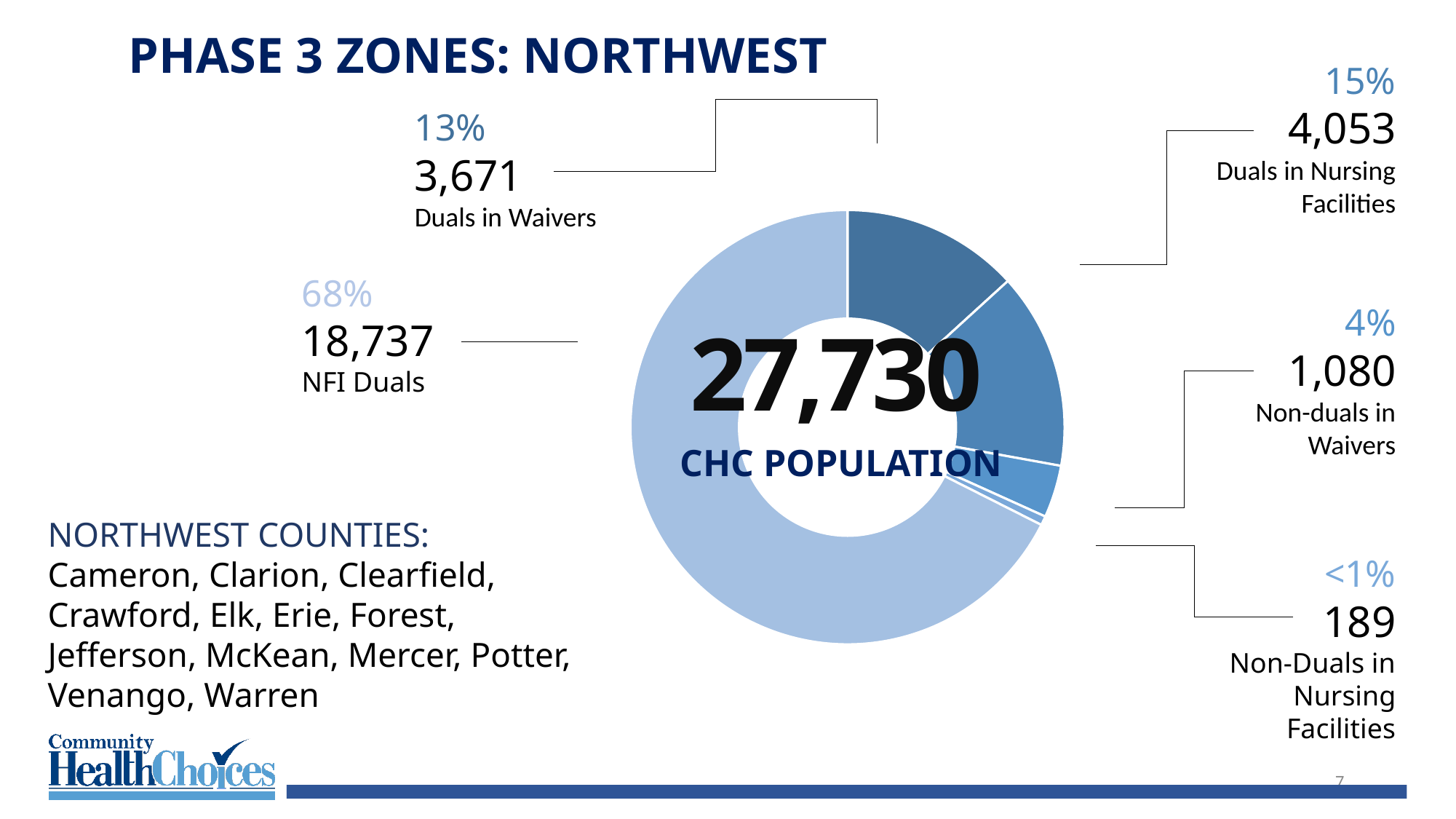
How many categories does the chart show? 5 What percentage of the CHC population are Duals in Nursing Facilities? 15% How many Duals in Waivers are shown? 3,671 Which category has the smallest share of the CHC population? Non-Duals in Nursing Facilities What is the difference between the number of Duals in Nursing Facilities and Duals in Waivers? 382 What is the total CHC population shown in the centre of the chart? 27,730 How many NFI Duals are shown? 18,737 Which is larger: Duals in Nursing Facilities or Non-duals in Waivers? Duals in Nursing Facilities How many Non-Duals in Nursing Facilities are shown? 189 What kind of chart is shown on the slide? Doughnut chart What share of the CHC population are Non-duals in Waivers? 4% Which category has the largest share of the CHC population? NFI Duals